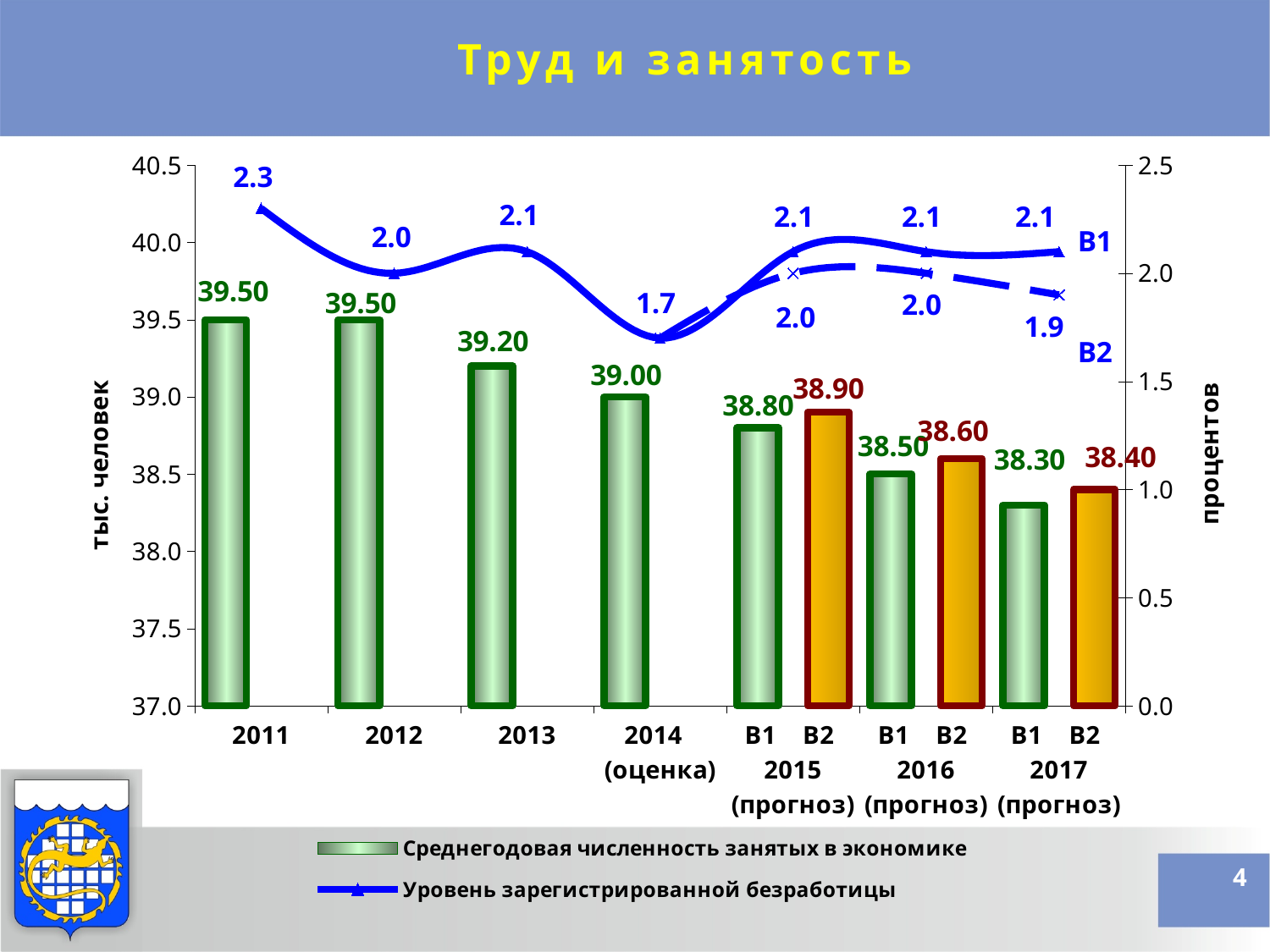
How many bars are plotted on the chart? 10 In which year is the registered unemployment rate highest? 2011 What is the difference between the employment values for 2011 and 2014 (оценка)? 0.50 What is the B2 unemployment rate value for 2017 (прогноз)? 1.9 What kind of chart is shown on the slide? Combined bar and line chart What is the average annual number of employed (Среднегодовая численность занятых в экономике) in 2011? 39.50 What is the employment value for the B2 bar in 2015 (прогноз)? 38.90 Which bar has the lowest employment value? B1 2017 (прогноз) Do the employment bars rise or fall from 2011 to 2014 (оценка)? Fall Which is larger, the employment value for B1 or B2 in 2016 (прогноз)? B2 How many series does the legend list? 2 What is the registered unemployment rate (Уровень зарегистрированной безработицы) in 2014 (оценка)? 1.7